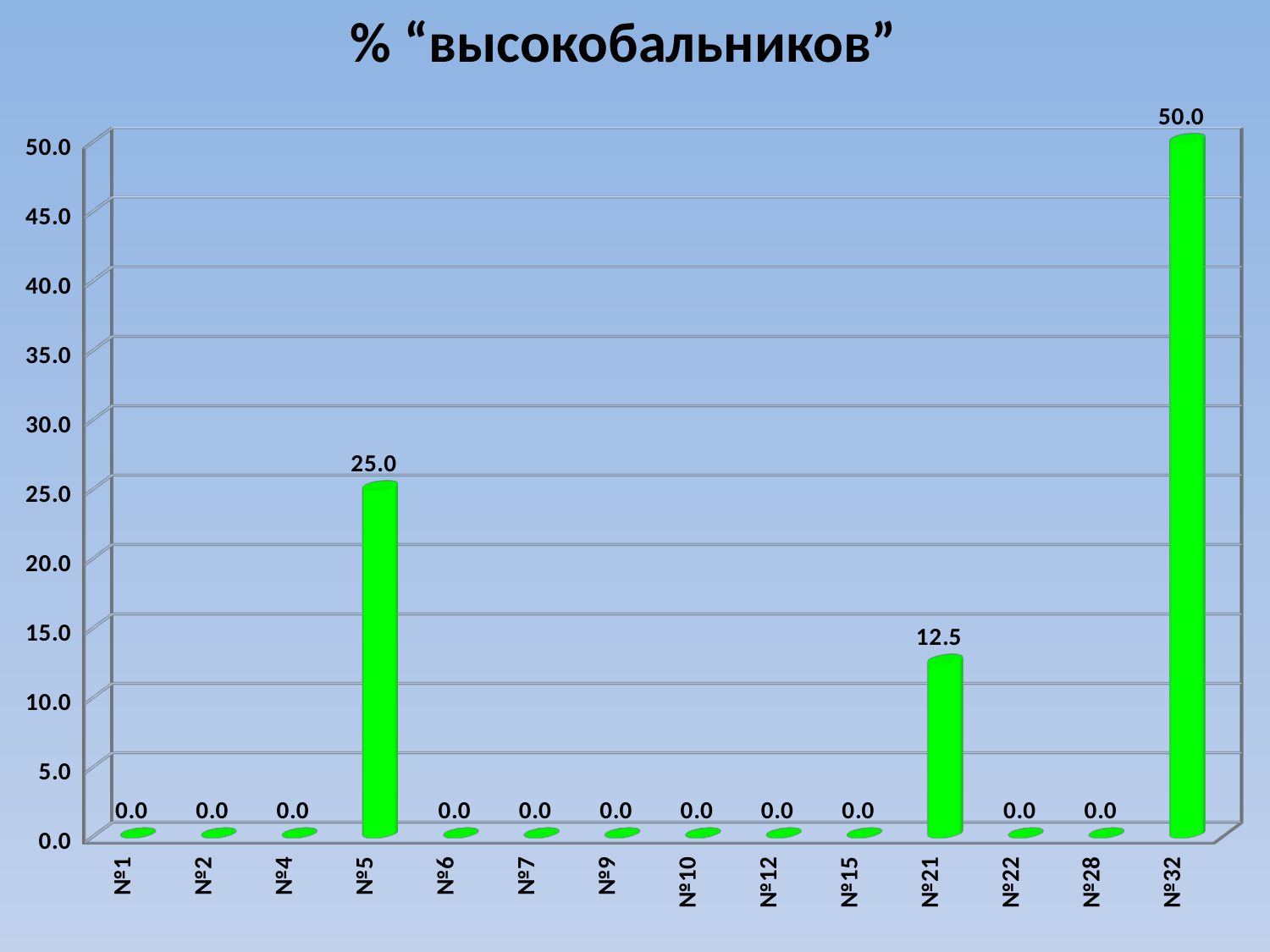
Which category has the highest value? №32 What kind of chart is this? bar chart What is the difference between the values for №32 and №5? 25.0 What is the value for №21? 12.5 What is the difference between the values for №5 and №21? 12.5 What is the value for №5? 25.0 How many categories have a value of 0.0? 11 How many categories are shown on the x axis? 14 Which is larger, the value for №21 or the value for №5? №5 What is the value for №15? 0.0 What is the title of the chart? % “высокобальников” What is the value for №32? 50.0